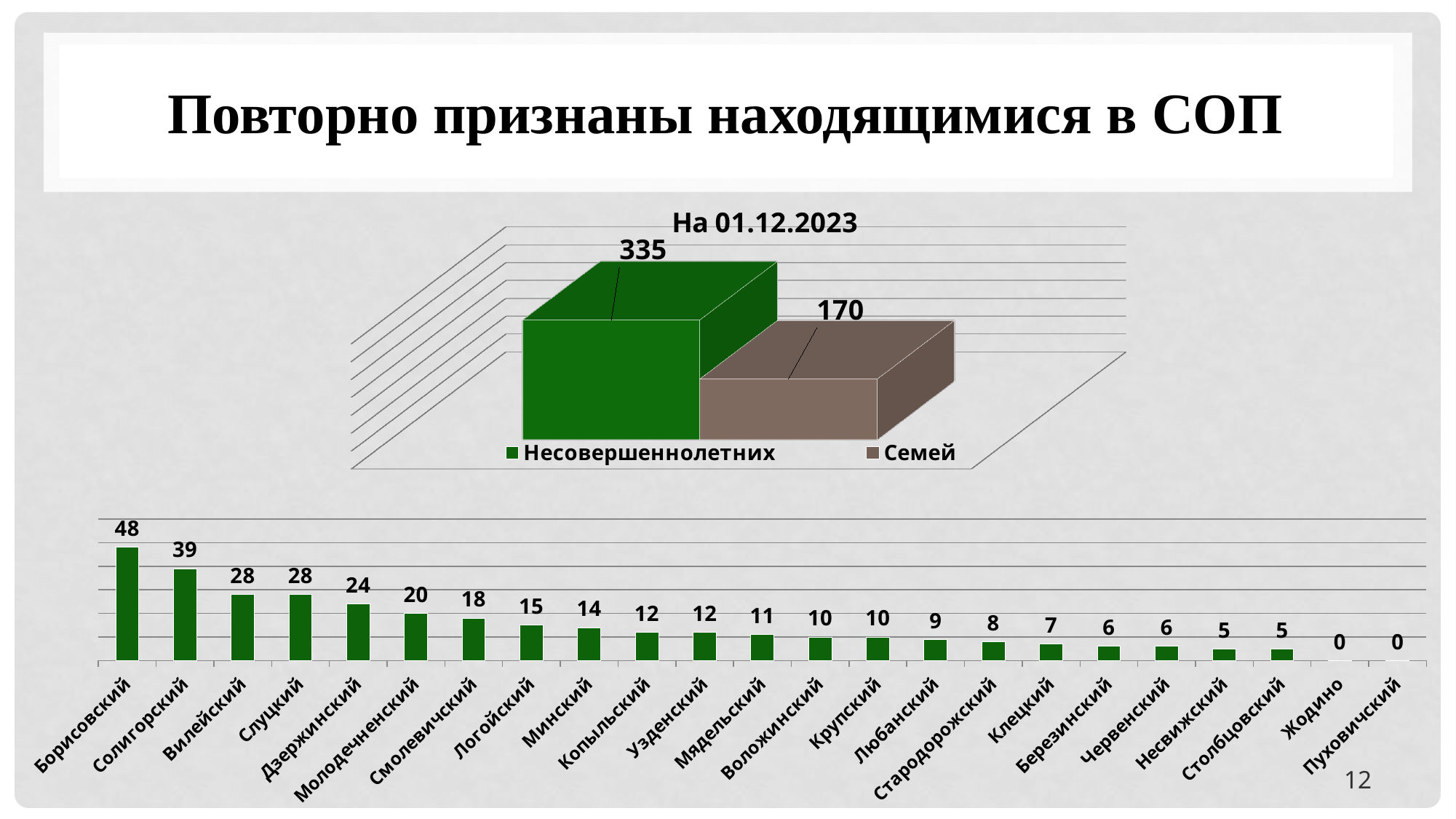
In the top chart titled 'На 01.12.2023', what is the value for Семей? 170 In the bottom chart, what is the value for Солигорский? 39 How many series does the legend of the top chart titled 'На 01.12.2023' list? 2 What type of chart is the bottom chart? bar chart In the bottom chart, what is the value for Минский? 14 How many categories are shown in the bottom chart? 23 In the bottom chart, what is the value for Дзержинский? 24 In the bottom chart, which is larger, Молодечненский or Логойский? Молодечненский In the bottom chart, which category has the highest value? Борисовский In the top chart titled 'На 01.12.2023', what is the value for Несовершеннолетних? 335 In the bottom chart, what is the difference between Борисовский and Солигорский? 9 In the top chart titled 'На 01.12.2023', what is the difference between Несовершеннолетних and Семей? 165